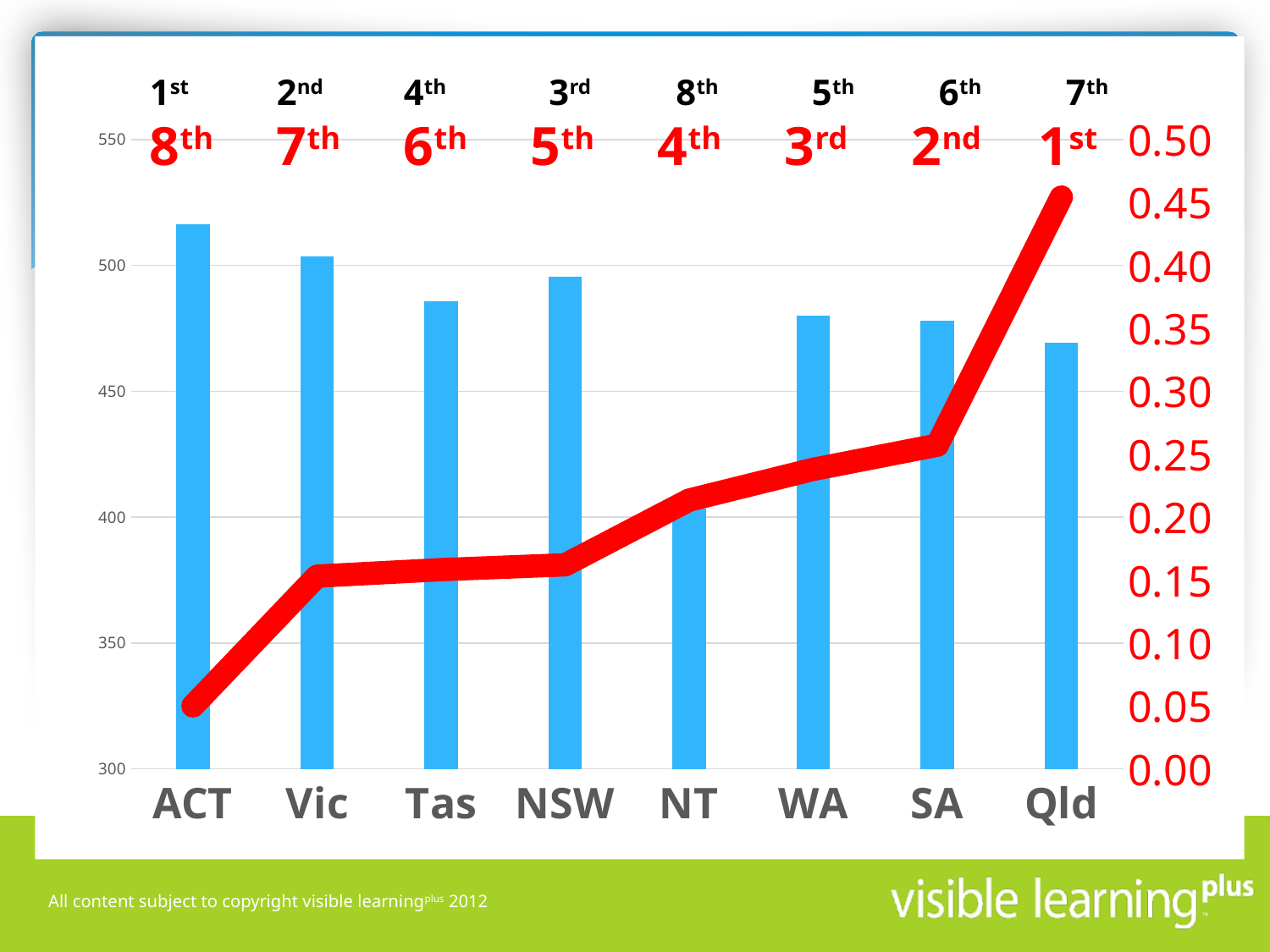
Does the red line generally rise or fall from ACT to Qld? rise How many states or territories are shown on the x axis? 8 Which state or territory has the tallest blue bar? ACT Which state or territory has the shortest blue bar? NT Is the blue bar value for ACT greater or less than 500? greater Which state or territory has the lowest point on the red line? ACT What kind of chart is shown on the slide? A combined bar and line chart Is the blue bar value for NT greater or less than 450? less Which has the taller blue bar, Vic or NT? Vic Is the red line value for Qld greater or less than 0.40? greater Which state or territory has the highest point on the red line? Qld